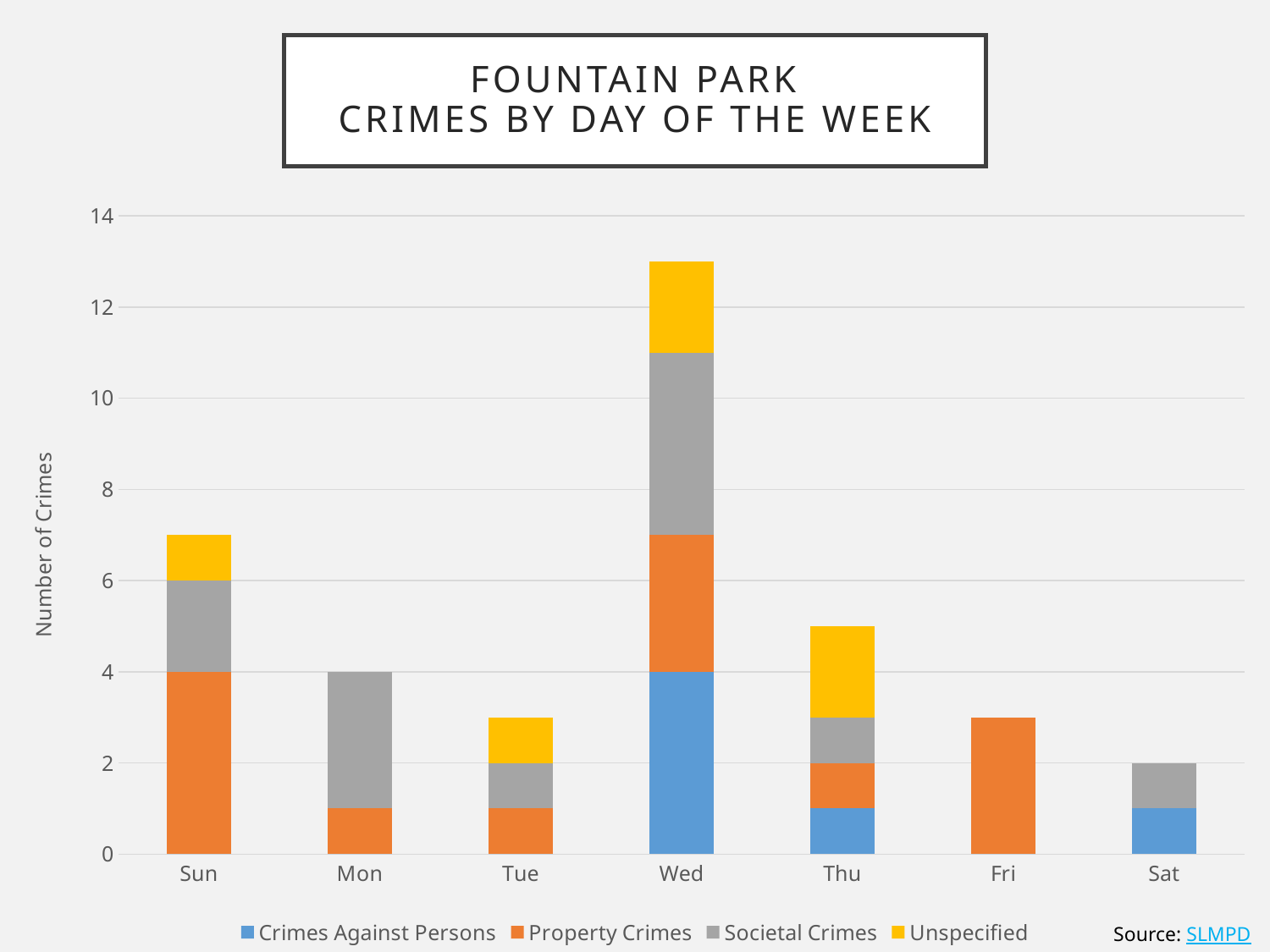
How many series does the legend list? 4 How many Property Crimes were recorded on Sun? 4 Which day of the week has the lowest total number of crimes? Sat Is the total number of crimes on Wed greater or less than 12? greater Which day of the week has the highest total number of crimes? Wed Which day has more total crimes, Sun or Thu? Sun Is the total number of crimes on Fri greater or less than 4? less What is the total number of crimes on Mon? 4 What kind of chart is shown on the slide? Stacked bar chart Which colour represents Unspecified crimes in the legend? Yellow What is the total number of crimes on Sat? 2 How many days are shown on the x axis? 7